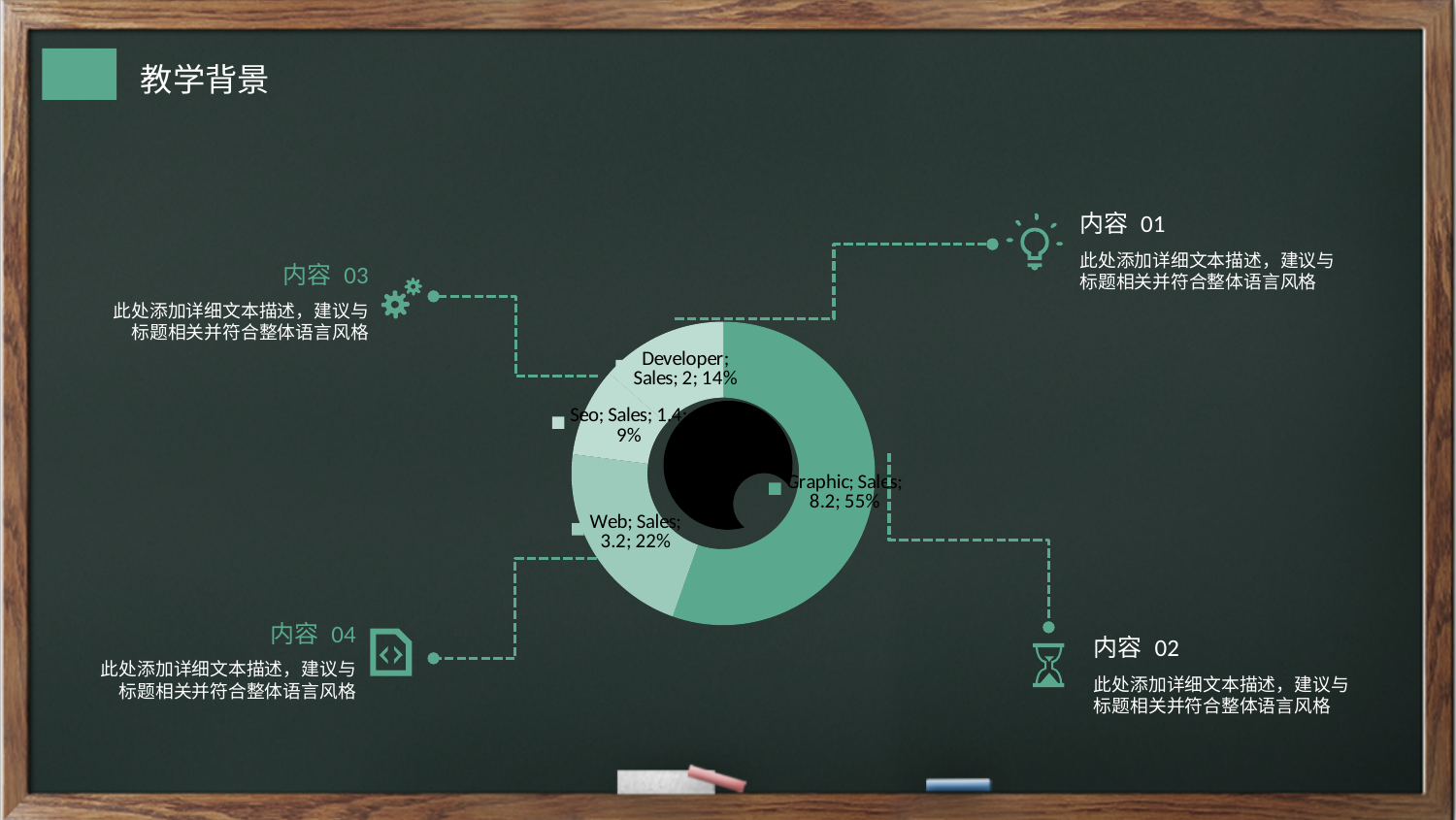
What is the Sales value for Web? 3.2 What share of the pie does Graphic represent? 55% What share of the pie does Web represent? 22% What is the difference between the Sales values for Graphic and Web? 5 What is the Sales value for Seo? 1.4 What kind of chart is shown on the slide? doughnut chart What is the Sales value for Developer? 2 Which category has the largest slice? Graphic Which category has the smallest slice? Seo How many categories does the pie chart have? 4 What is the Sales value for Graphic? 8.2 Which is larger, the Sales value for Developer or for Seo? Developer